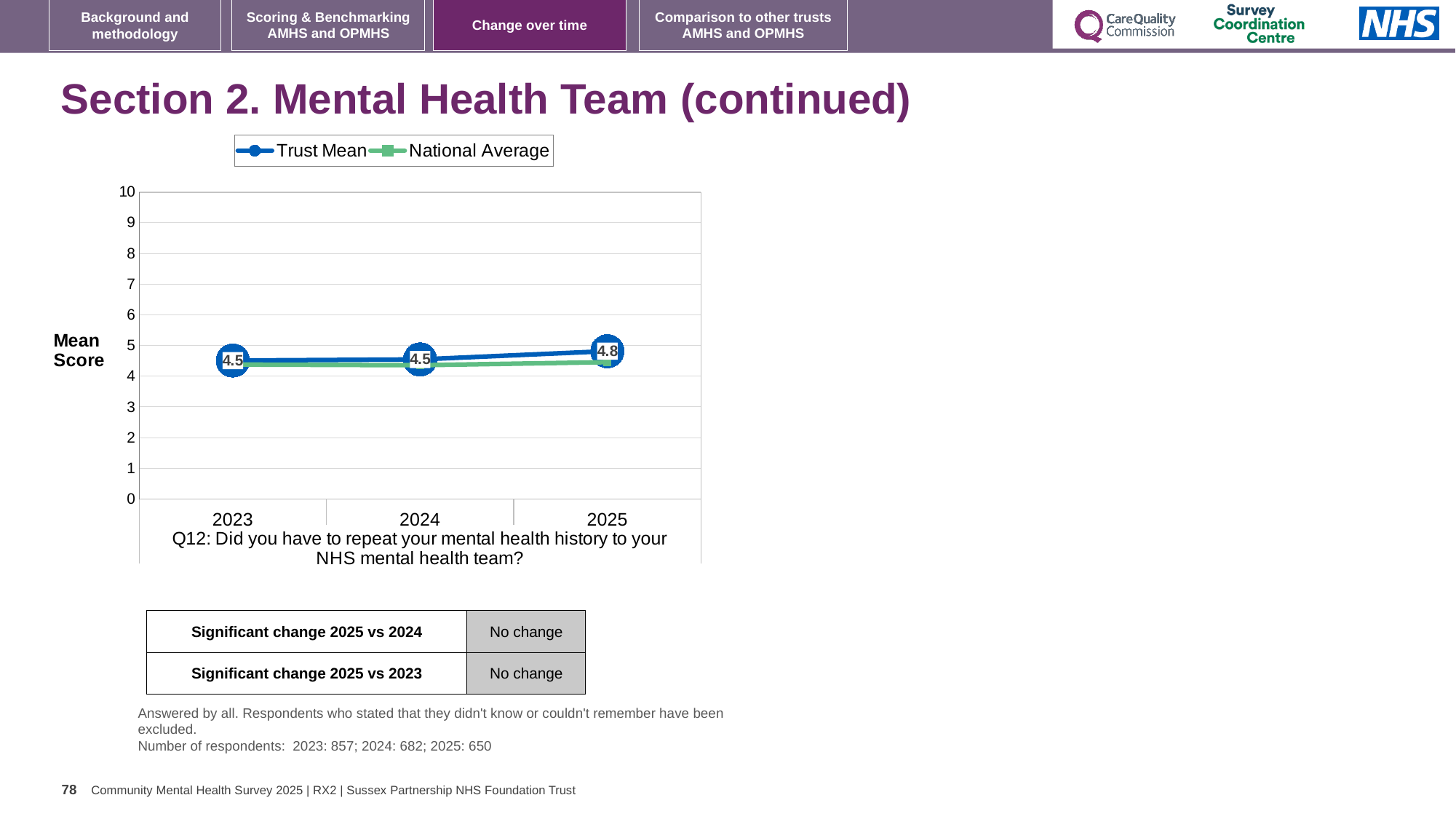
What is the Trust Mean value for 2024? 4.5 What is the label on the y axis of the chart? Mean Score Does the Trust Mean rise or fall from 2023 to 2025? rise What is the Trust Mean value for 2023? 4.5 What is the difference between the Trust Mean in 2025 and in 2024? 0.3 Is the National Average value for 2025 greater or less than 5? less What is the Trust Mean value for 2025? 4.8 In which year is the Trust Mean highest? 2025 How many series does the legend list? 2 Which is larger, the Trust Mean for 2025 or for 2023? 2025 How many years are plotted on the x axis? 3 What kind of chart is shown on the slide? line chart